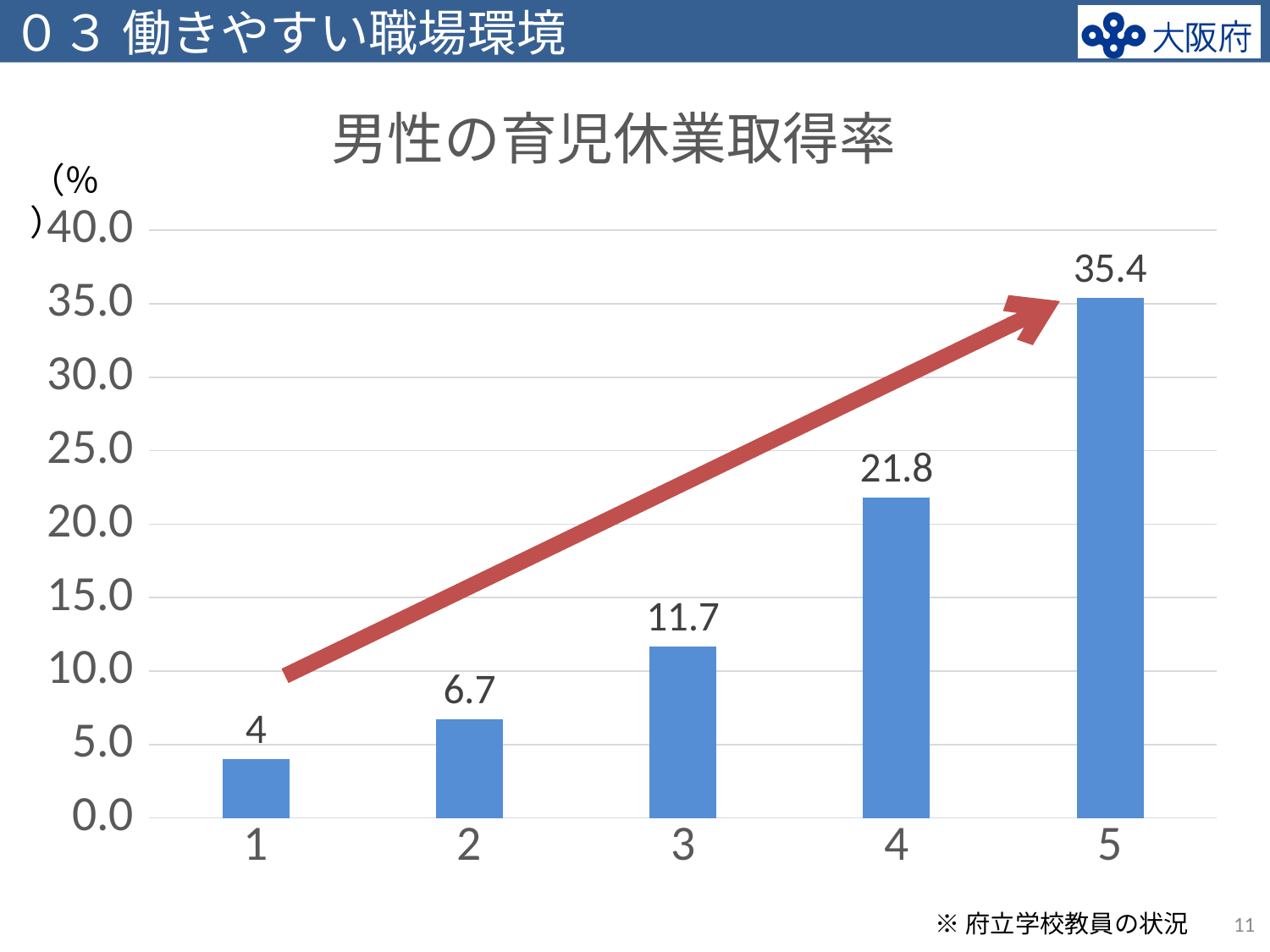
What is the value for category 5? 35.4 What kind of chart is shown? bar chart What is the difference between the values for category 2 and category 1? 2.7 What is the value for category 3? 11.7 What is the value for category 1? 4 Is the value for category 4 greater or less than 20.0? greater Which is larger, the value for category 3 or the value for category 4? 4 What is the difference between the values for category 5 and category 4? 13.6 Which category has the lowest value? 1 How many bars are in the chart? 5 Do the values rise or fall from category 1 to category 5? rise Which category has the highest value? 5